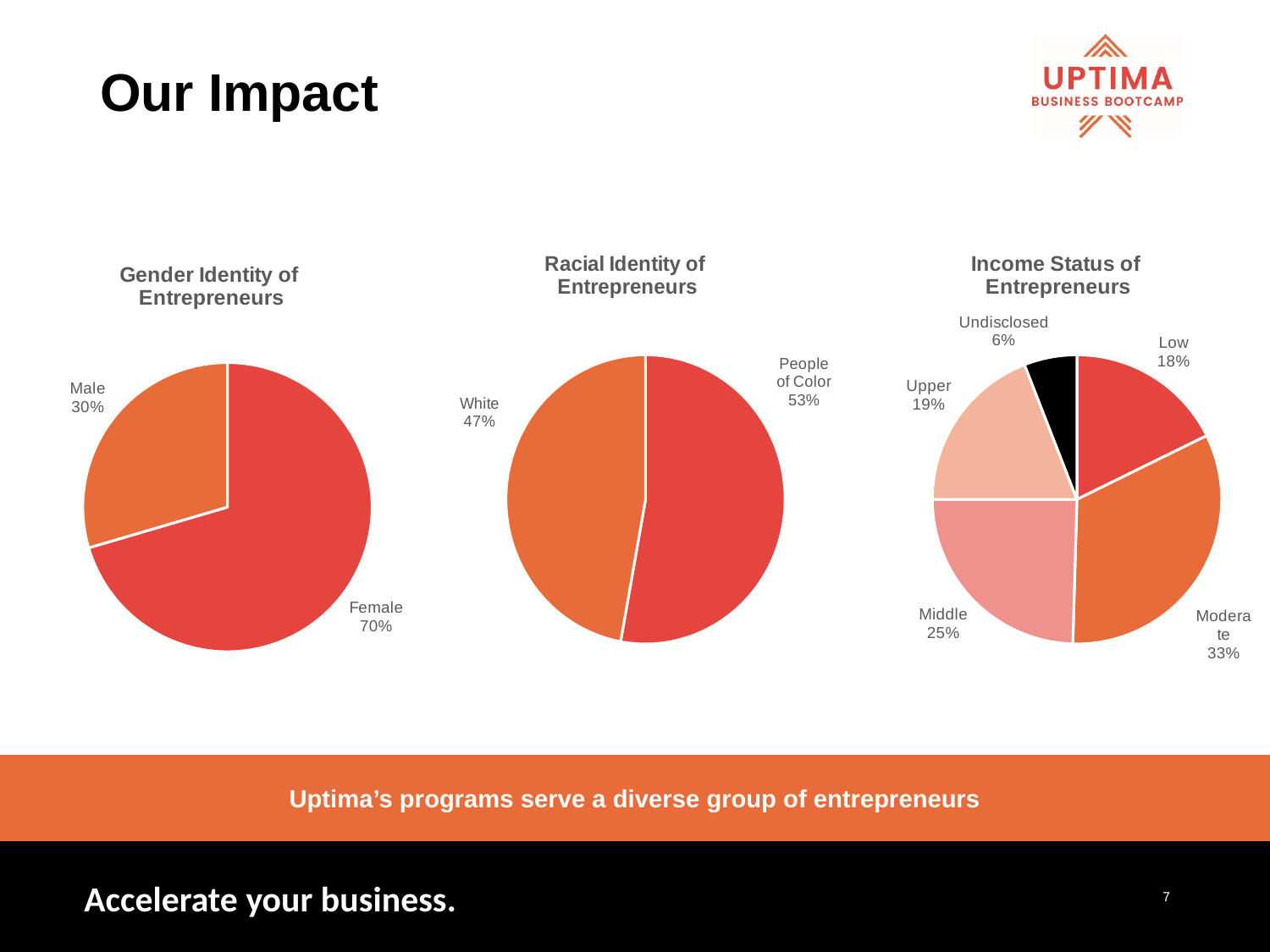
In the 'Income Status of Entrepreneurs' chart, what percentage of entrepreneurs are Middle income? 25% In the 'Income Status of Entrepreneurs' chart, what is the difference between the Moderate and Low shares? 15% In the 'Income Status of Entrepreneurs' chart, which category has the largest share? Moderate In the 'Racial Identity of Entrepreneurs' chart, which slice is larger, White or People of Color? People of Color In the 'Gender Identity of Entrepreneurs' chart, what percentage of entrepreneurs are Female? 70% What type of chart is used for 'Racial Identity of Entrepreneurs'? Pie chart In the 'Income Status of Entrepreneurs' chart, which category has the smallest share? Undisclosed In the 'Gender Identity of Entrepreneurs' chart, what percentage of entrepreneurs are Male? 30% In the 'Gender Identity of Entrepreneurs' chart, what is the difference between the Female and Male shares? 40% In the 'Income Status of Entrepreneurs' chart, how many categories are shown? 5 In the 'Racial Identity of Entrepreneurs' chart, what share is People of Color? 53% How many charts are shown on the slide? 3